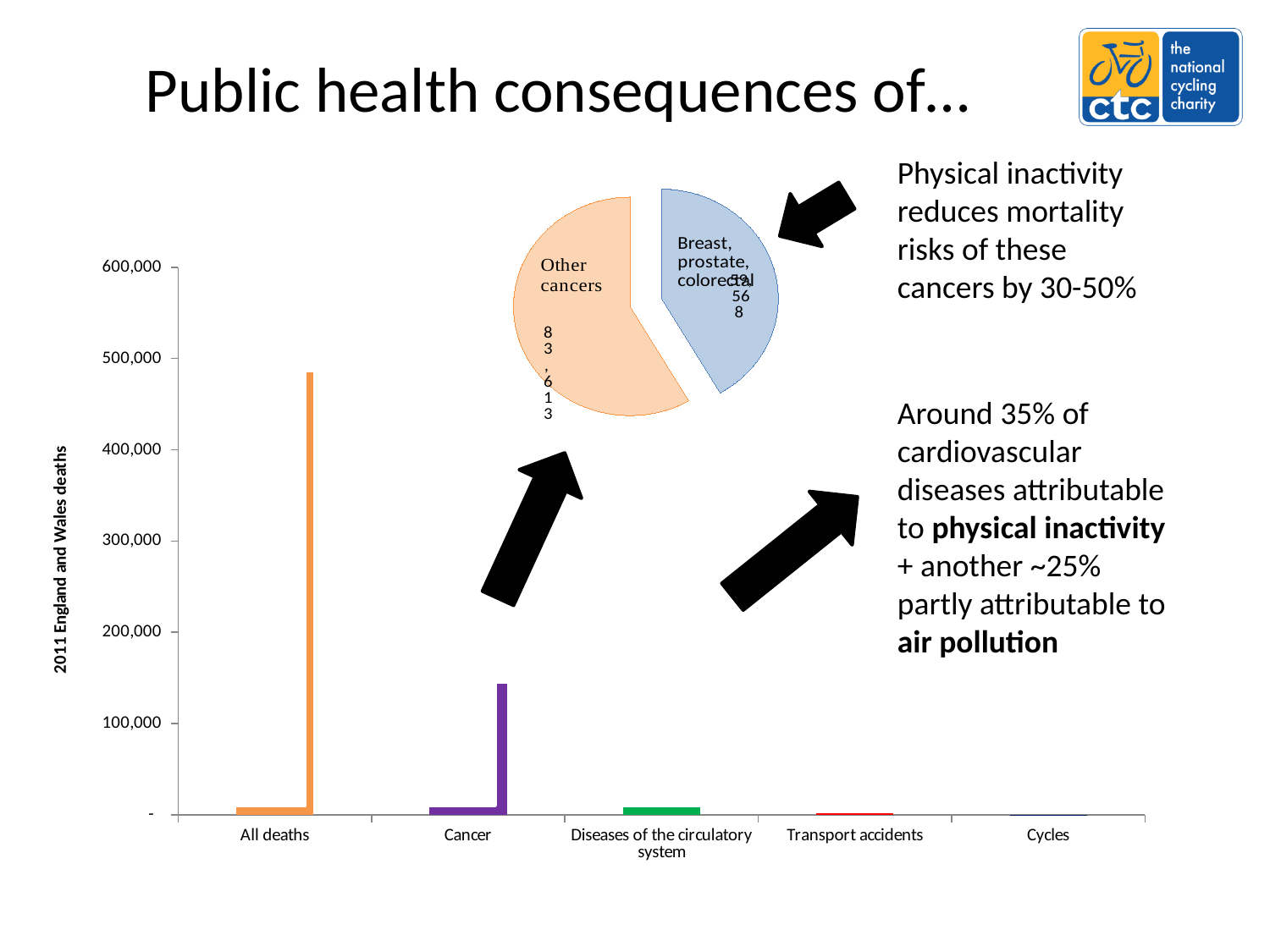
On the bar chart at the bottom left, is the value for All deaths greater or less than 400,000? greater On the bar chart at the bottom left, which is larger, the value for All deaths or the value for Cancer? All deaths On the bar chart at the bottom left, is the value for Cancer greater or less than 100,000? greater On the bar chart at the bottom left, which category has the highest value? All deaths On the bar chart at the bottom left, what kind of chart is it? bar chart On the pie chart at the top centre, which slice is larger, Other cancers or Breast, prostate, colorectal? Other cancers On the bar chart at the bottom left, how many categories are shown on the x axis? 5 On the bar chart at the bottom left, is the value for Cancer greater or less than 200,000? less On the bar chart at the bottom left, do the values rise or fall moving from left to right along the x axis? fall On the bar chart at the bottom left, which category has the lowest value? Cycles On the bar chart at the bottom left, what is the label on the vertical axis? 2011 England and Wales deaths